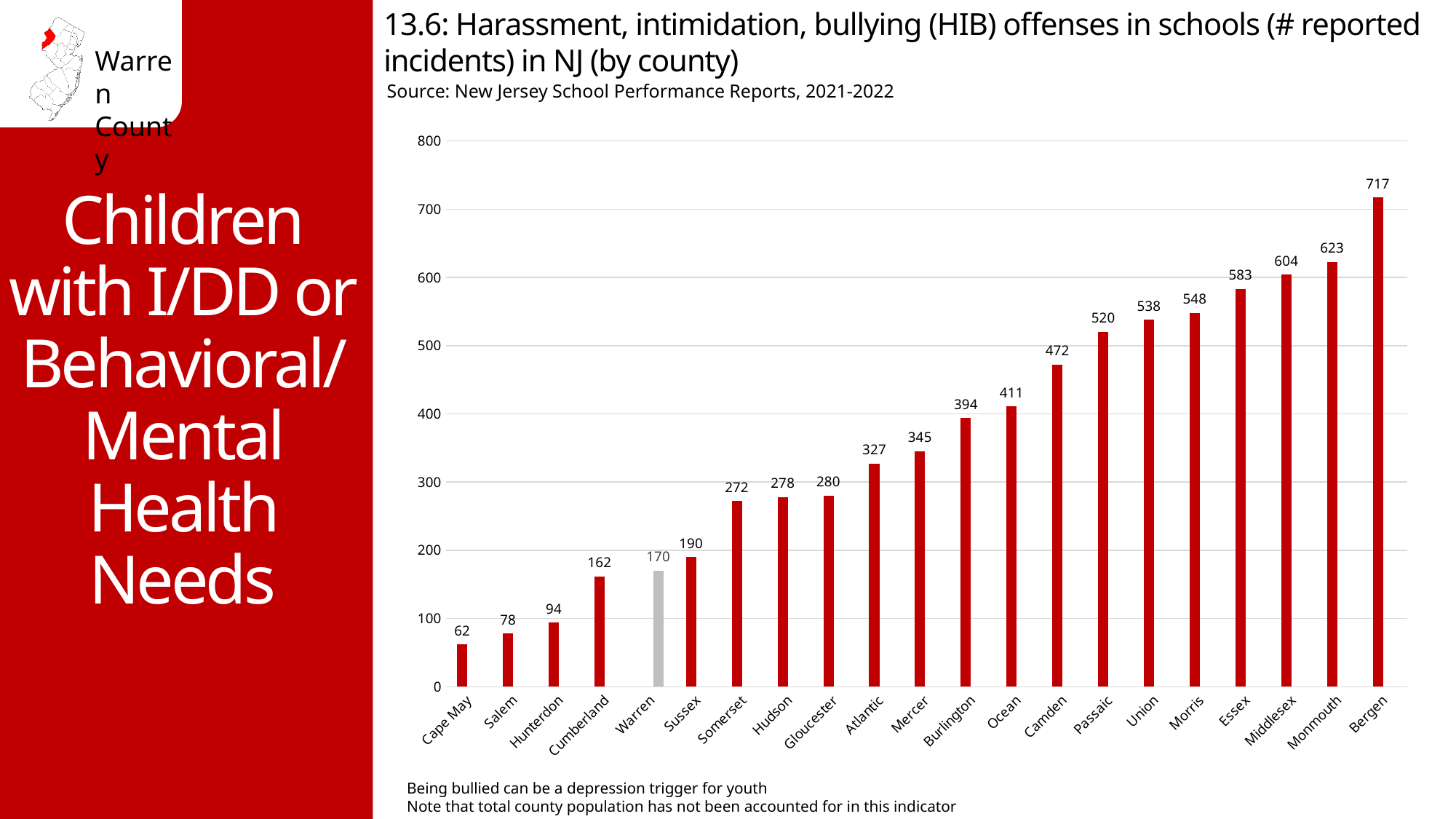
Which county has the highest number of reported HIB incidents? Bergen What is the number of reported HIB incidents for Warren county? 170 How many counties are shown on the chart? 21 Is the value for Passaic greater or less than 500? greater What is the number of reported HIB incidents for Bergen county? 717 Which county has the lowest number of reported HIB incidents? Cape May What type of chart is used to show HIB incidents by county? Bar chart What is the difference in reported HIB incidents between Sussex and Warren? 20 What is the difference in reported HIB incidents between Bergen and Cape May? 655 Which county has more reported HIB incidents, Camden or Ocean? Camden What is the number of reported HIB incidents for Hudson county? 278 Which county's bar is shown in grey rather than red? Warren